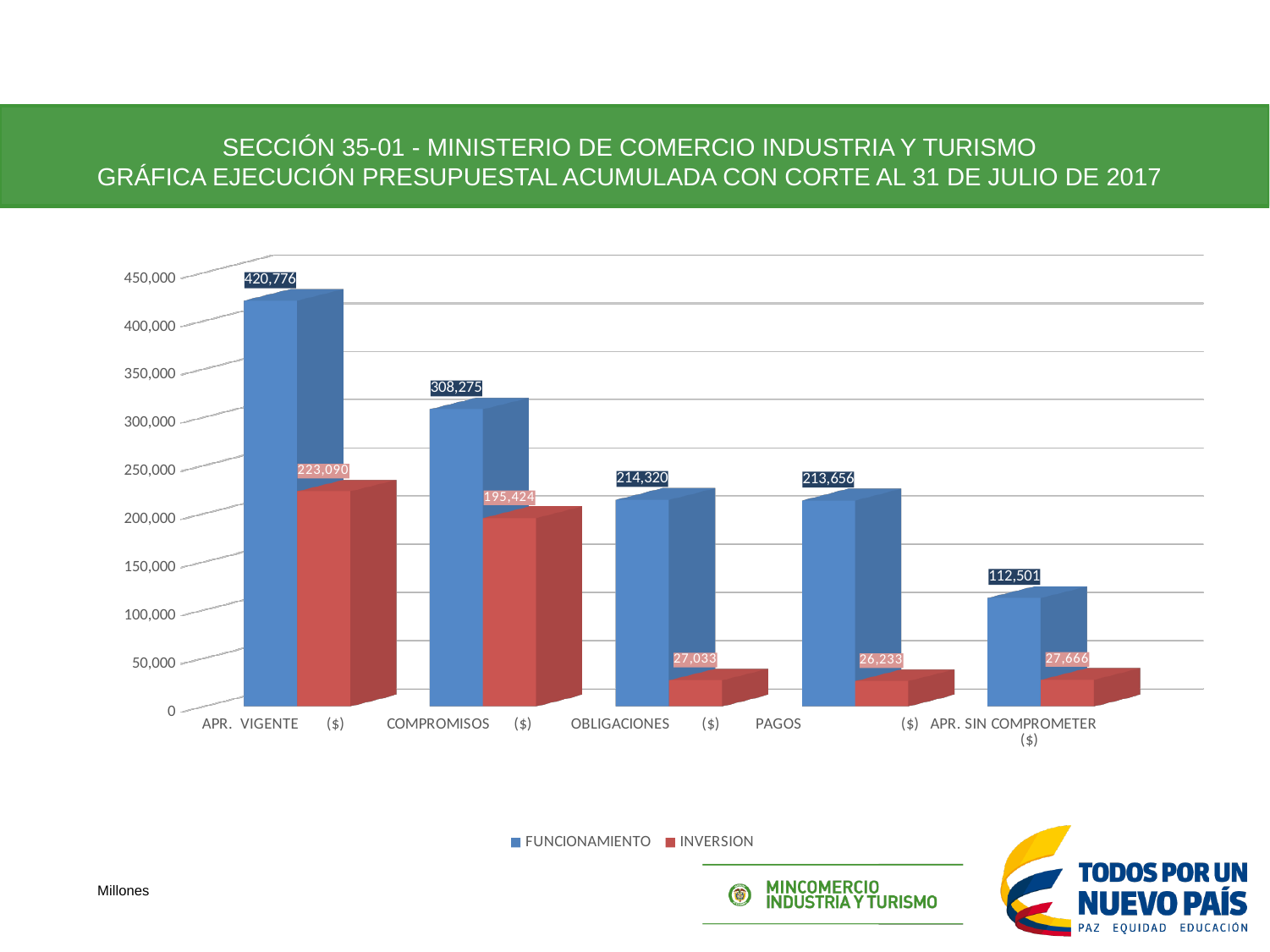
Which category has the lowest FUNCIONAMIENTO value? APR. SIN COMPROMETER What is the INVERSION value for COMPROMISOS? 195,424 What kind of chart is shown on the slide? Bar chart Which is larger, the INVERSION value for PAGOS or for APR. SIN COMPROMETER? APR. SIN COMPROMETER How many categories are shown on the x axis? 5 What is the difference between the FUNCIONAMIENTO values for OBLIGACIONES and PAGOS? 664 How many series does the legend list? 2 Which category has the highest INVERSION value? APR. VIGENTE What is the FUNCIONAMIENTO value for APR. SIN COMPROMETER? 112,501 What is the FUNCIONAMIENTO value for APR. VIGENTE? 420,776 What is the difference between the FUNCIONAMIENTO and INVERSION values for APR. VIGENTE? 197,686 What is the INVERSION value for OBLIGACIONES? 27,033